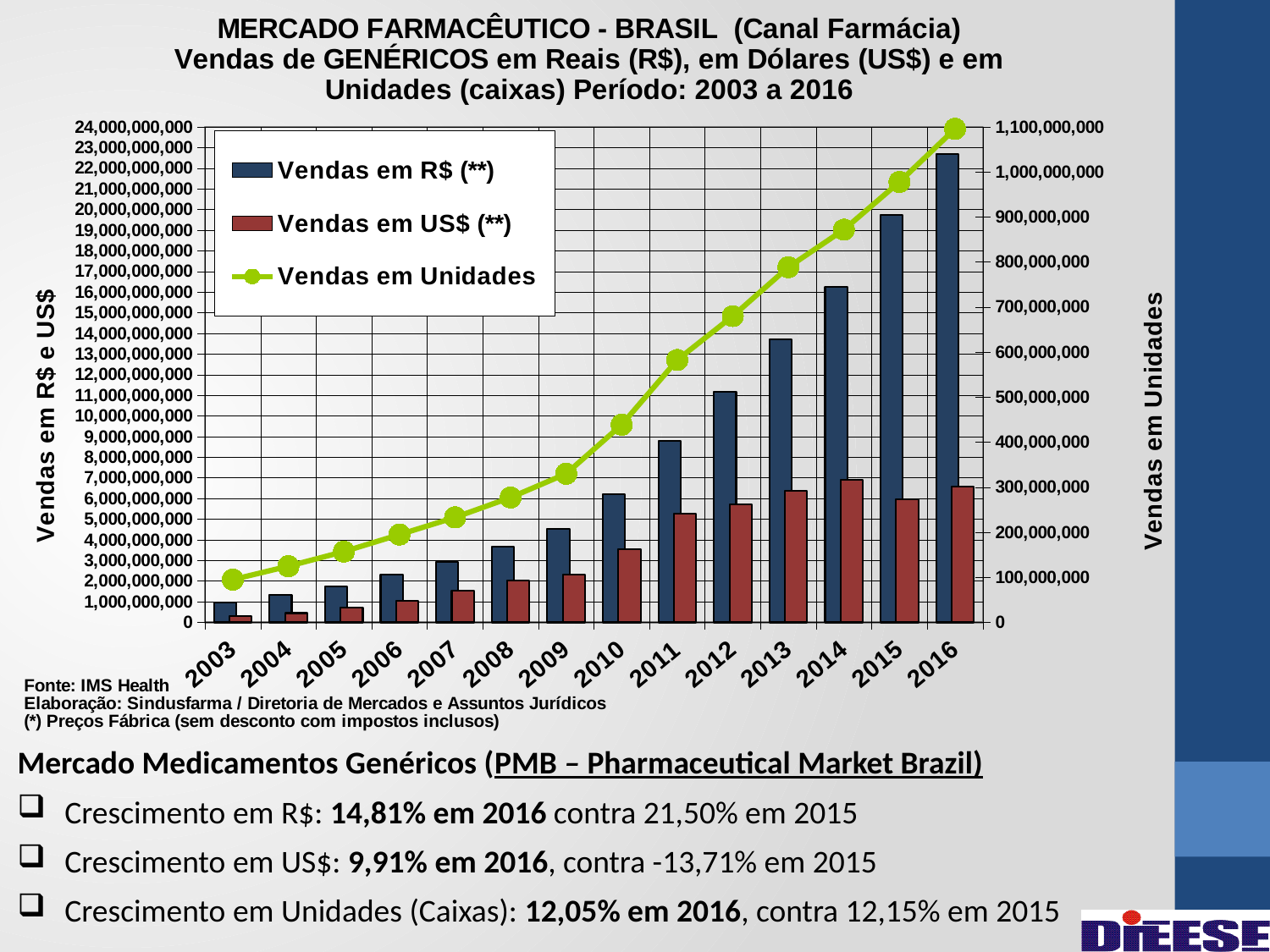
Is the value for Vendas em Unidades in 2011 greater or less than 500,000,000? greater Is the value for Vendas em R$ (**) in 2016 greater or less than 20,000,000,000? greater In which year is the value for Vendas em R$ (**) lowest? 2003 Which series is plotted as a line with markers rather than as bars? Vendas em Unidades How many years are shown along the x axis? 14 What kind of chart is shown on the slide? A combined bar and line chart Is the value for Vendas em US$ (**) in 2010 greater or less than 4,000,000,000? less Which is larger for Vendas em US$ (**): the value for 2014 or the value for 2015? 2014 Do the values for Vendas em Unidades rise or fall from 2003 to 2016? rise How many series does the legend list? 3 In which year is the value for Vendas em R$ (**) highest? 2016